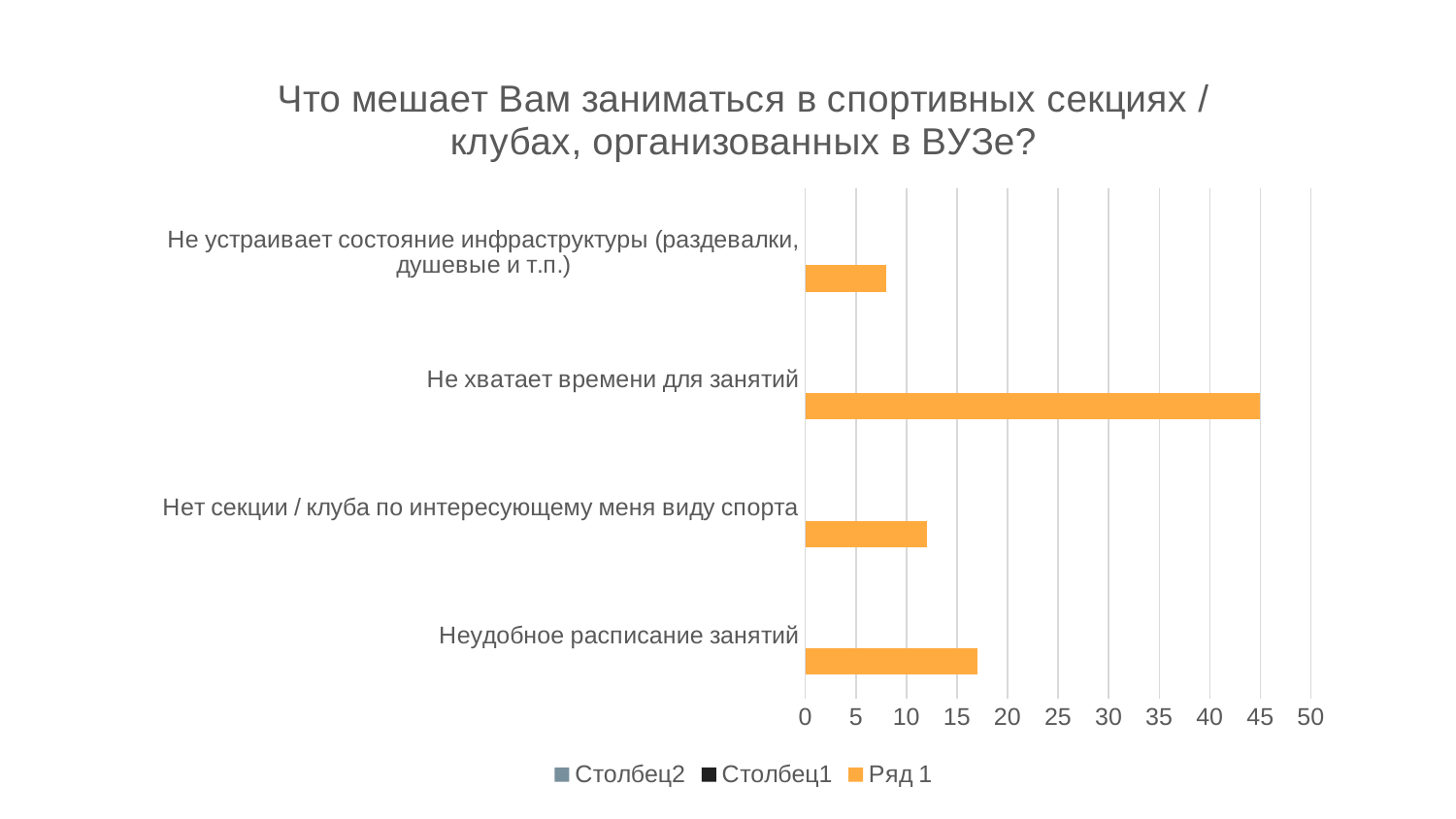
What kind of chart is shown on the slide? bar chart What is the value for "Не хватает времени для занятий"? 45 How many categories are shown on the chart? 4 Is the value for "Не устраивает состояние инфраструктуры (раздевалки, душевые и т.п.)" greater or less than 10? less What colour are the bars on the chart? orange Which is larger: the value for "Неудобное расписание занятий" or the value for "Нет секции / клуба по интересующему меня виду спорта"? Неудобное расписание занятий Which category has the lowest value? Не устраивает состояние инфраструктуры (раздевалки, душевые и т.п.) Is the value for "Нет секции / клуба по интересующему меня виду спорта" greater or less than 15? less Which category has the highest value? Не хватает времени для занятий What is the title of the chart? Что мешает Вам заниматься в спортивных секциях / клубах, организованных в ВУЗе? Is the value for "Неудобное расписание занятий" greater or less than 15? greater How many series does the legend list? 3